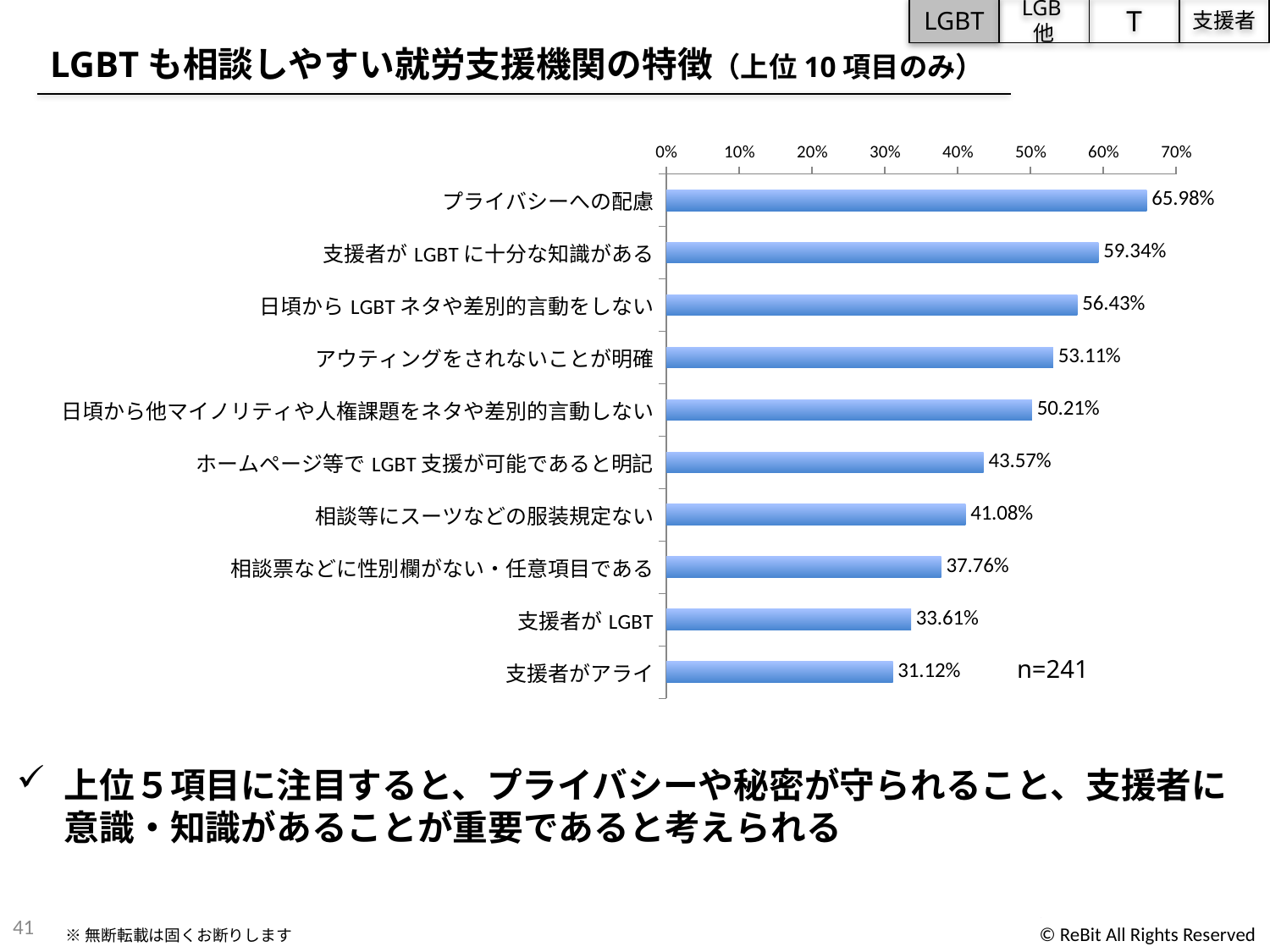
What kind of chart is shown on the slide? bar chart What is the sample size (n) shown on the chart? n=241 How many categories are shown in the chart? 10 What is the difference between the values for プライバシーへの配慮 and 支援者が LGBT に十分な知識がある? 6.64% Which category has the lowest value? 支援者がアライ What is the value for 支援者がアライ? 31.12% Is the value for アウティングをされないことが明確 greater or less than 50%? greater Which category has the highest value? プライバシーへの配慮 What is the value for プライバシーへの配慮? 65.98% What is the value for ホームページ等で LGBT 支援が可能であると明記? 43.57% Which is larger, the value for 相談等にスーツなどの服装規定ない or the value for 支援者が LGBT? 相談等にスーツなどの服装規定ない What is the value for 相談票などに性別欄がない・任意項目である? 37.76%